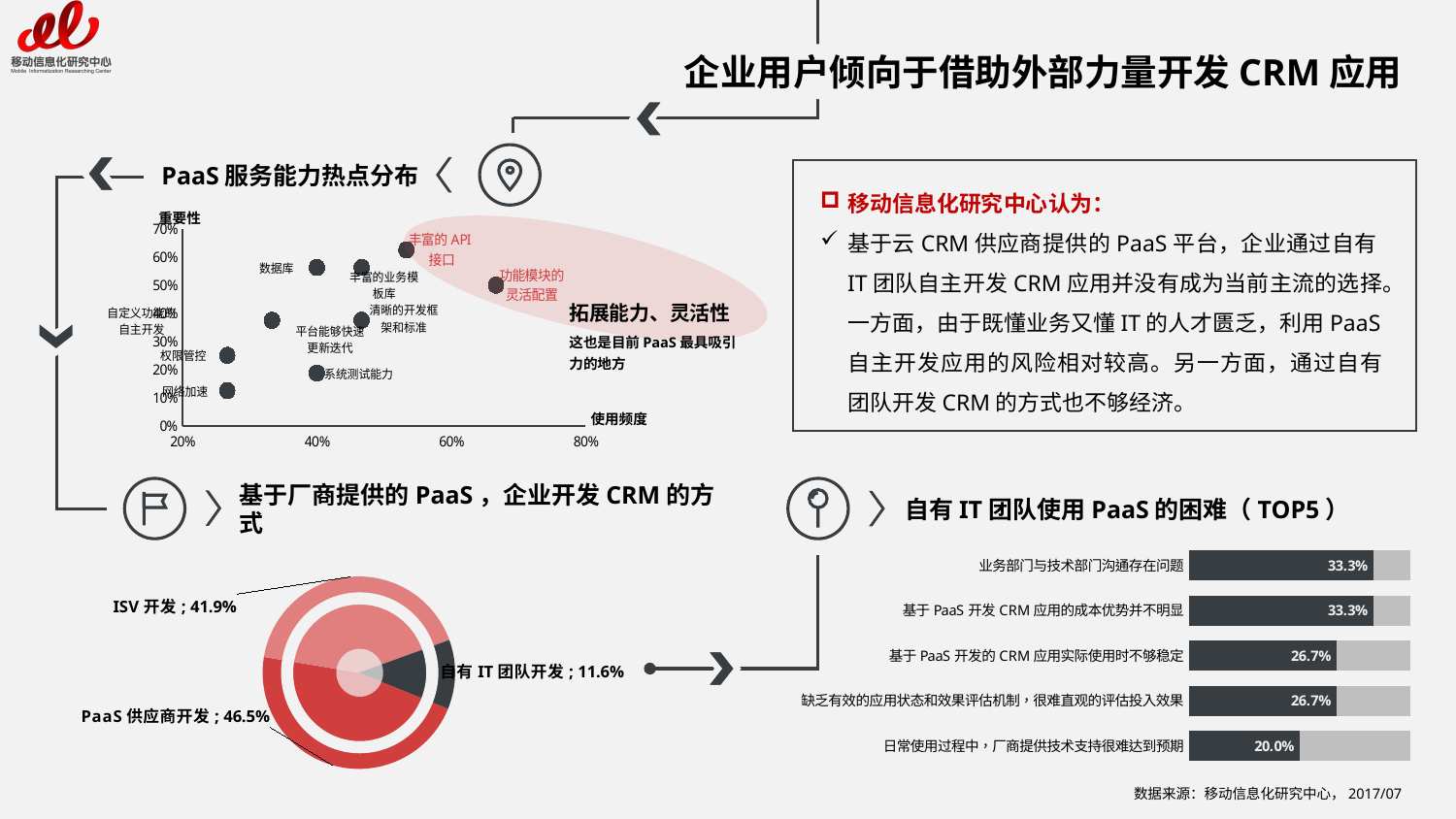
In the pie chart 基于厂商提供的 PaaS，企业开发 CRM 的方式, which category has the largest share? PaaS 供应商开发 In the pie chart 基于厂商提供的 PaaS，企业开发 CRM 的方式, what is the difference between PaaS 供应商开发 and ISV 开发? 4.6% In the pie chart 基于厂商提供的 PaaS，企业开发 CRM 的方式, what share is ISV 开发? 41.9% In the bar chart 自有 IT 团队使用 PaaS 的困难（TOP5）, what is the difference between 业务部门与技术部门沟通存在问题 and 日常使用过程中，厂商提供技术支持很难达到预期? 13.3% What kind of chart is 自有 IT 团队使用 PaaS 的困难（TOP5）? bar chart In the bar chart 自有 IT 团队使用 PaaS 的困难（TOP5）, what is the value for 基于 PaaS 开发的 CRM 应用实际使用时不够稳定? 26.7% In the scatter chart PaaS 服务能力热点分布, is the 重要性 value for 丰富的 API 接口 greater or less than 50%? greater In the bar chart 自有 IT 团队使用 PaaS 的困难（TOP5）, which category has the lowest value? 日常使用过程中，厂商提供技术支持很难达到预期 How many categories does the pie chart 基于厂商提供的 PaaS，企业开发 CRM 的方式 show? 3 In the pie chart 基于厂商提供的 PaaS，企业开发 CRM 的方式, what share is 自有 IT 团队开发? 11.6% In the scatter chart PaaS 服务能力热点分布, is the 使用频率 value for 网络加速 greater or less than 40%? less In the bar chart 自有 IT 团队使用 PaaS 的困难（TOP5）, which is larger: 基于 PaaS 开发 CRM 应用的成本优势并不明显 or 缺乏有效的应用状态和效果评估机制，很难直观的评估投入效果? 基于 PaaS 开发 CRM 应用的成本优势并不明显